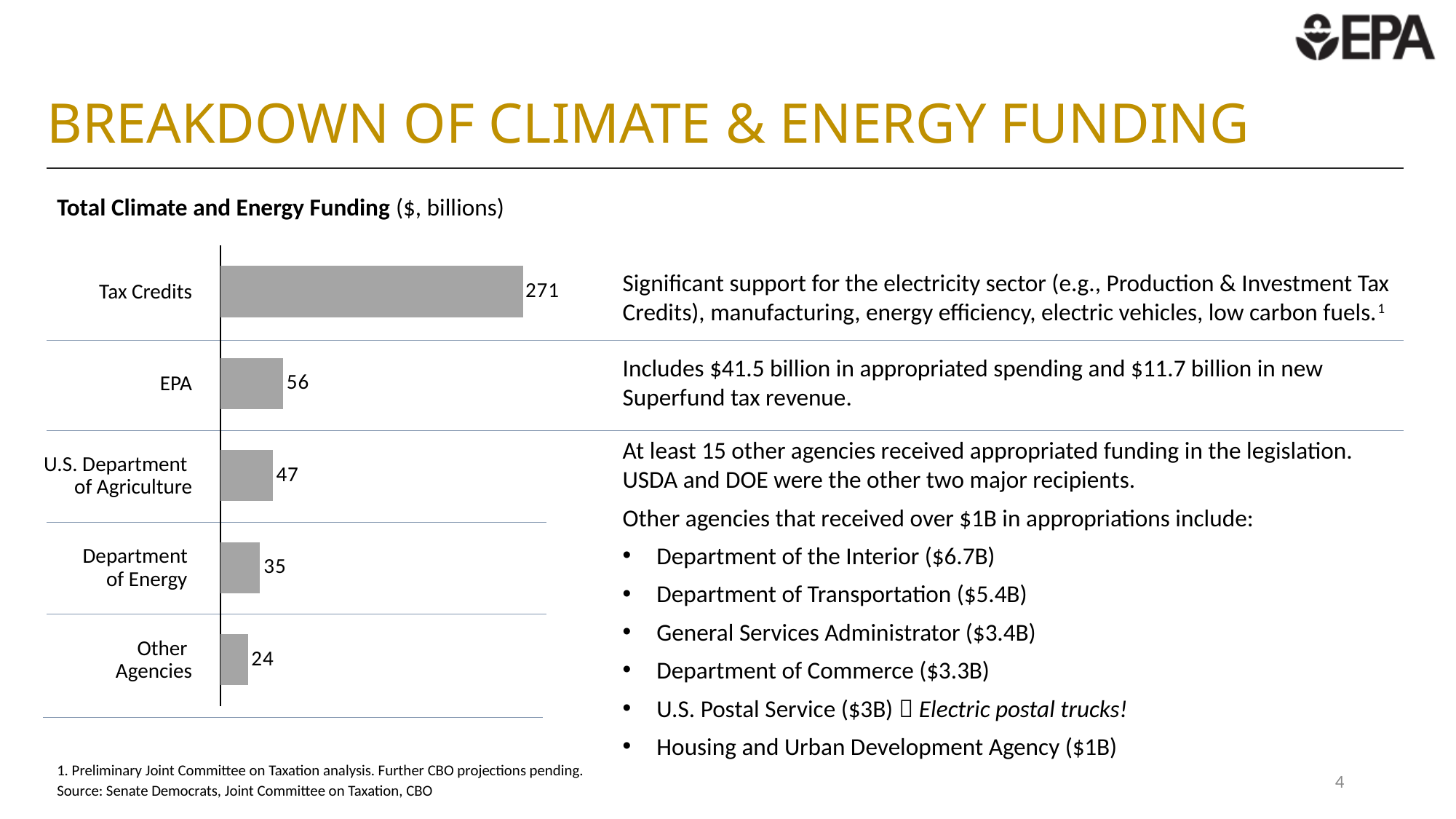
How many categories are shown in the Total Climate and Energy Funding chart? 5 What is the value for Other Agencies in the chart? 24 What is the value for Department of Energy in the chart? 35 What kind of chart is used to show Total Climate and Energy Funding? Bar chart What is the value for Tax Credits in the Total Climate and Energy Funding chart? 271 Which is larger, the value for EPA or the value for Department of Energy? EPA Which category has the highest value in the Total Climate and Energy Funding chart? Tax Credits What is the difference between the values for U.S. Department of Agriculture and Department of Energy? 12 What is the value for EPA in the Total Climate and Energy Funding chart? 56 What is the value for U.S. Department of Agriculture in the chart? 47 Which category has the lowest value in the Total Climate and Energy Funding chart? Other Agencies What is the difference between the values for Tax Credits and EPA? 215